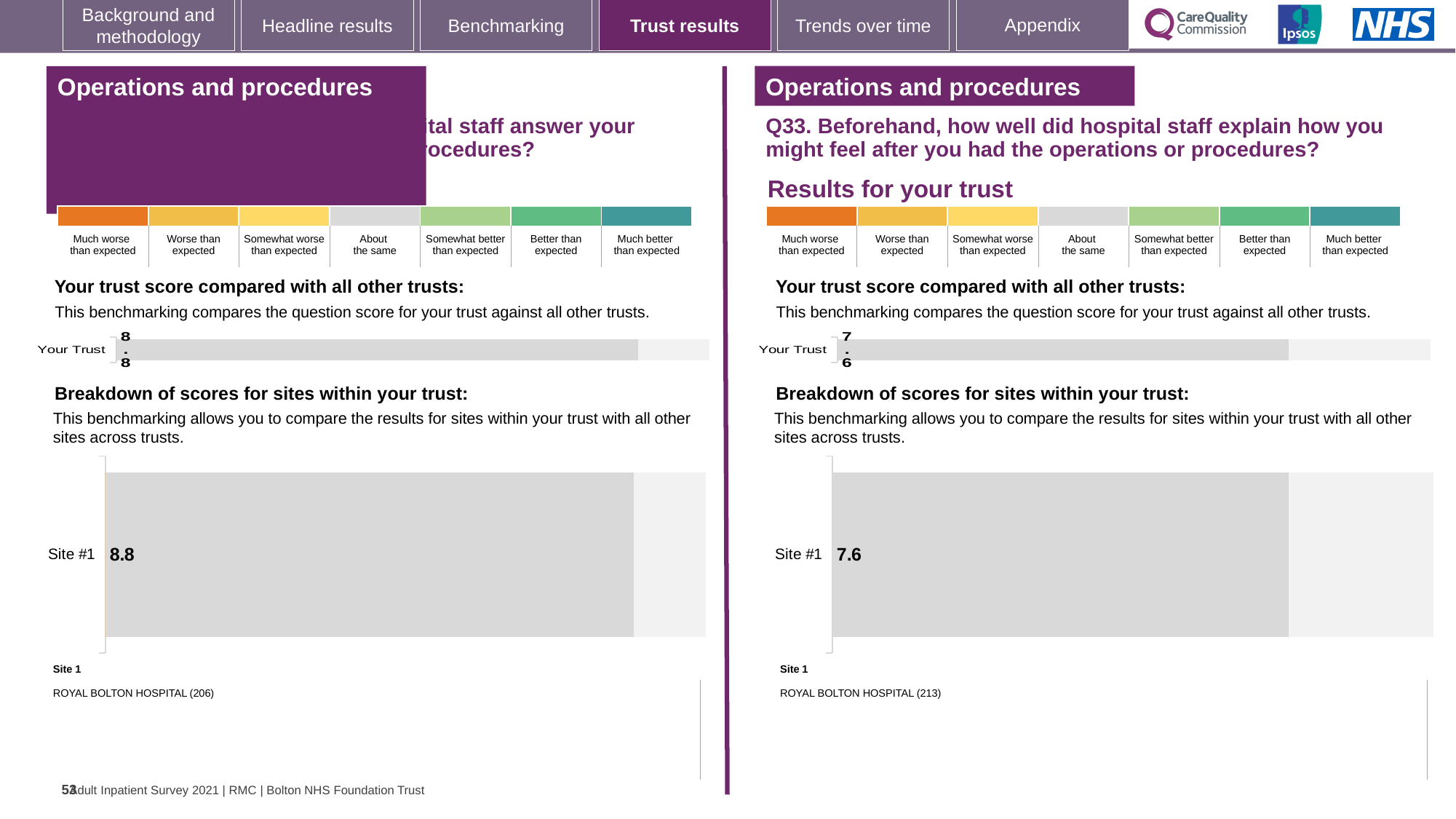
On the right panel (Q33), what is the score shown for Site #1? 7.6 What is the difference between the Your Trust score on the left panel and the Your Trust score on the right panel (Q33)? 1.2 Is the Your Trust score on the right panel (Q33) greater or less than the Your Trust score on the left panel? less On the right panel (Q33), what is the score shown for Your Trust? 7.6 On the left panel, what is the score shown for Your Trust? 8.8 What is the difference between the Site #1 score on the left panel and the Site #1 score on the right panel (Q33)? 1.2 On the right panel (Q33), which site is listed as Site 1? ROYAL BOLTON HOSPITAL (213) On the left panel, what is the score shown for Site #1? 8.8 Which is larger: the Site #1 score on the left panel or the Site #1 score on the right panel (Q33)? Left panel (8.8) What type of chart is used to show the Site #1 score on the right panel (Q33)? Bar chart On the left panel, which site is listed as Site 1? ROYAL BOLTON HOSPITAL (206) How many sites are shown in the breakdown of scores on the right panel (Q33)? 1